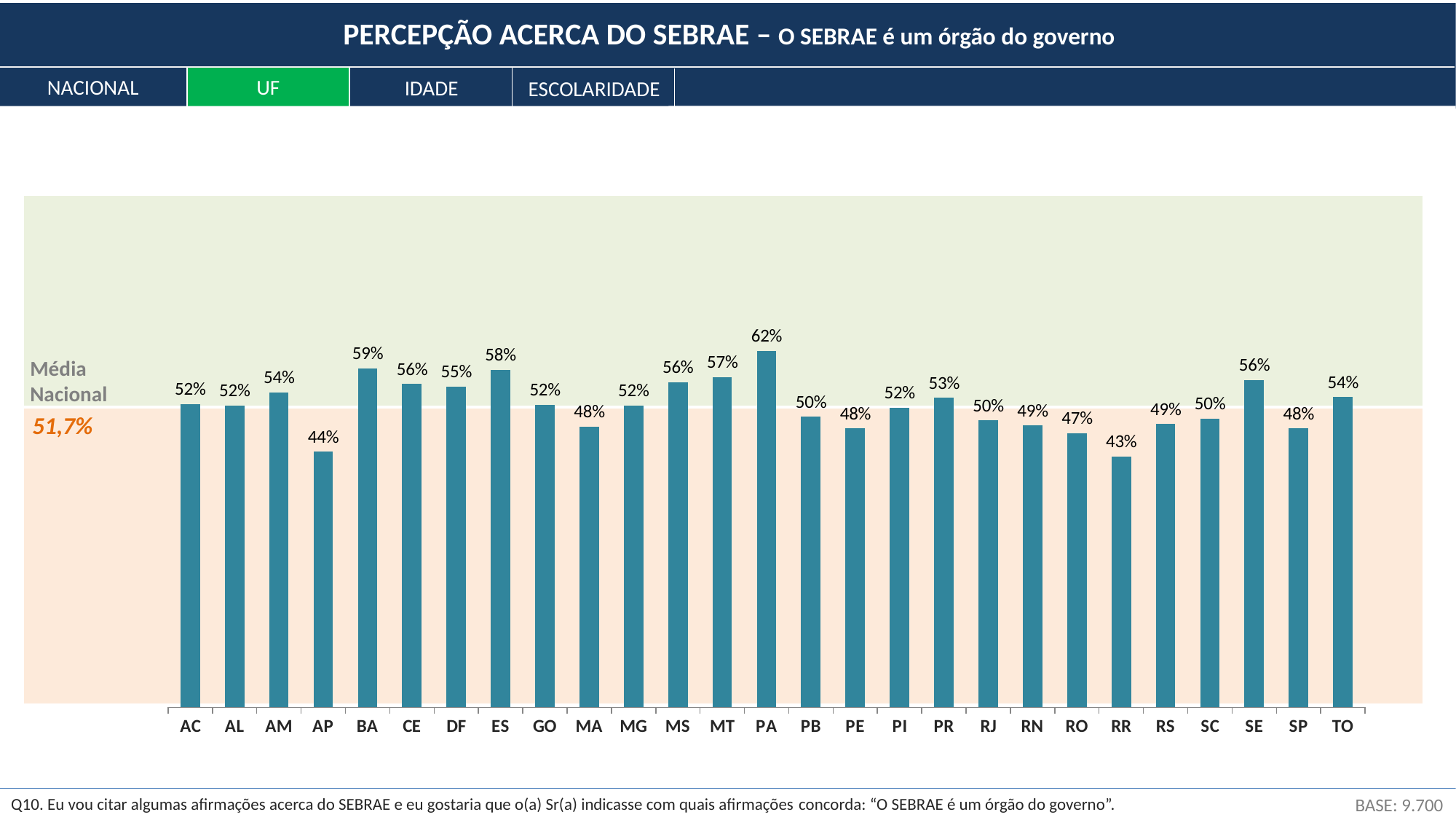
What is the value for AP? 44% Which state has the lowest value? RR What is the difference between the values for BA and RR? 16% Which is larger, the value for AM or the value for MA? AM How many states (UF) are shown on the x axis? 27 What is the difference between the values for ES and SP? 10% Which state has the highest value? PA What is the value for PA? 62% Which is larger, the value for CE or the value for RO? CE What kind of chart is shown on the slide? bar chart What is the value of the Média Nacional shown on the chart? 51,7% What is the value for MT? 57%